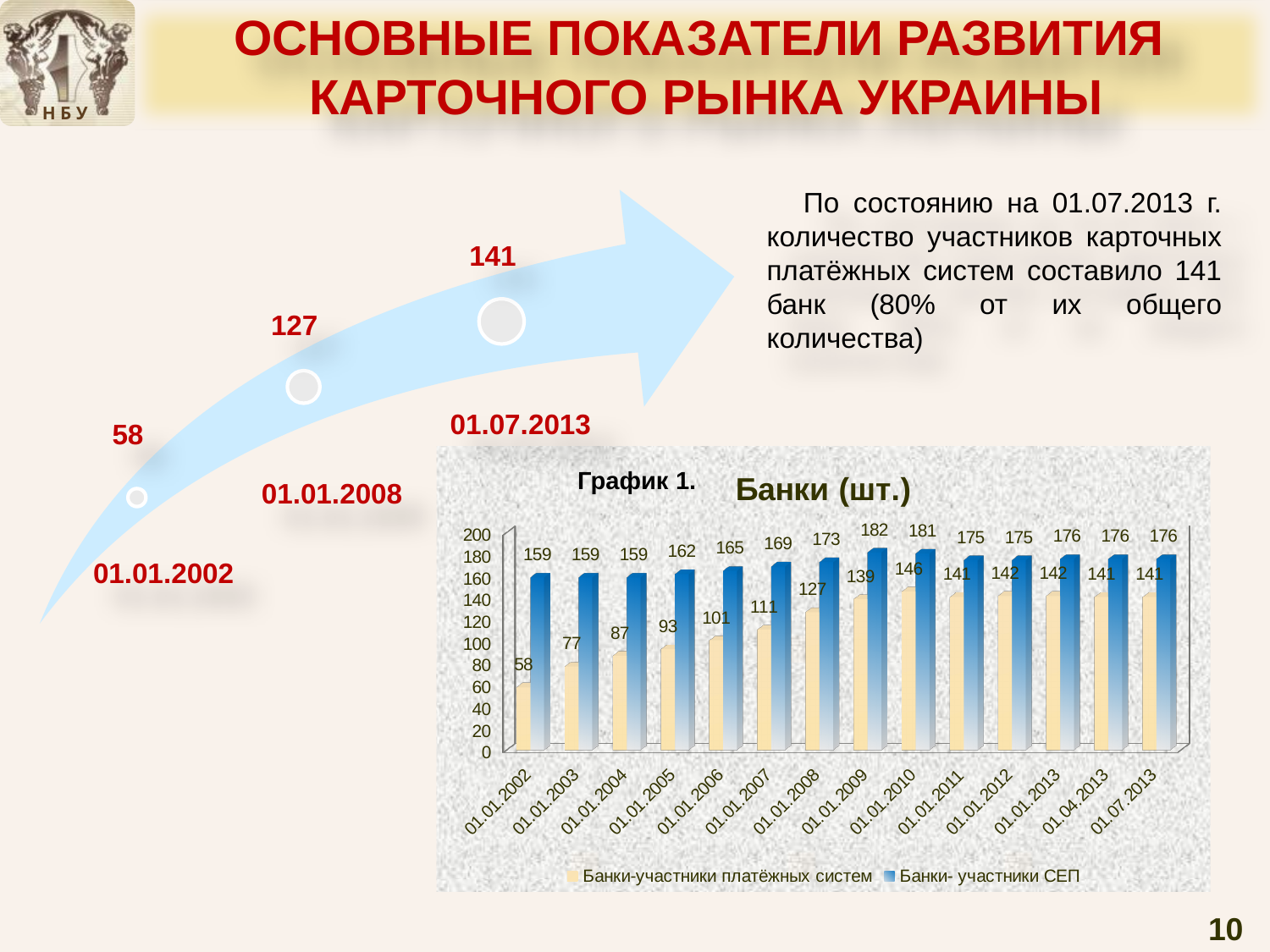
How many dates (categories) are shown on the x axis of the chart? 14 How many series does the chart legend list? 2 On which date is the value for Банки- участники СЕП highest? 01.01.2009 What is the value for Банки-участники платёжных систем on 01.07.2013? 141 On which date is the value for Банки-участники платёжных систем lowest? 01.01.2002 What is the value for Банки-участники платёжных систем on 01.01.2002? 58 Which is larger on 01.01.2005: Банки-участники платёжных систем or Банки- участники СЕП? Банки- участники СЕП What is the value for Банки- участники СЕП on 01.01.2009? 182 What is the difference between Банки- участники СЕП and Банки-участники платёжных систем on 01.01.2010? 35 Do the values for Банки-участники платёжных систем rise or fall from 01.01.2002 to 01.01.2010? rise What type of chart is shown on the slide? bar chart What is the title of the chart? Банки (шт.)